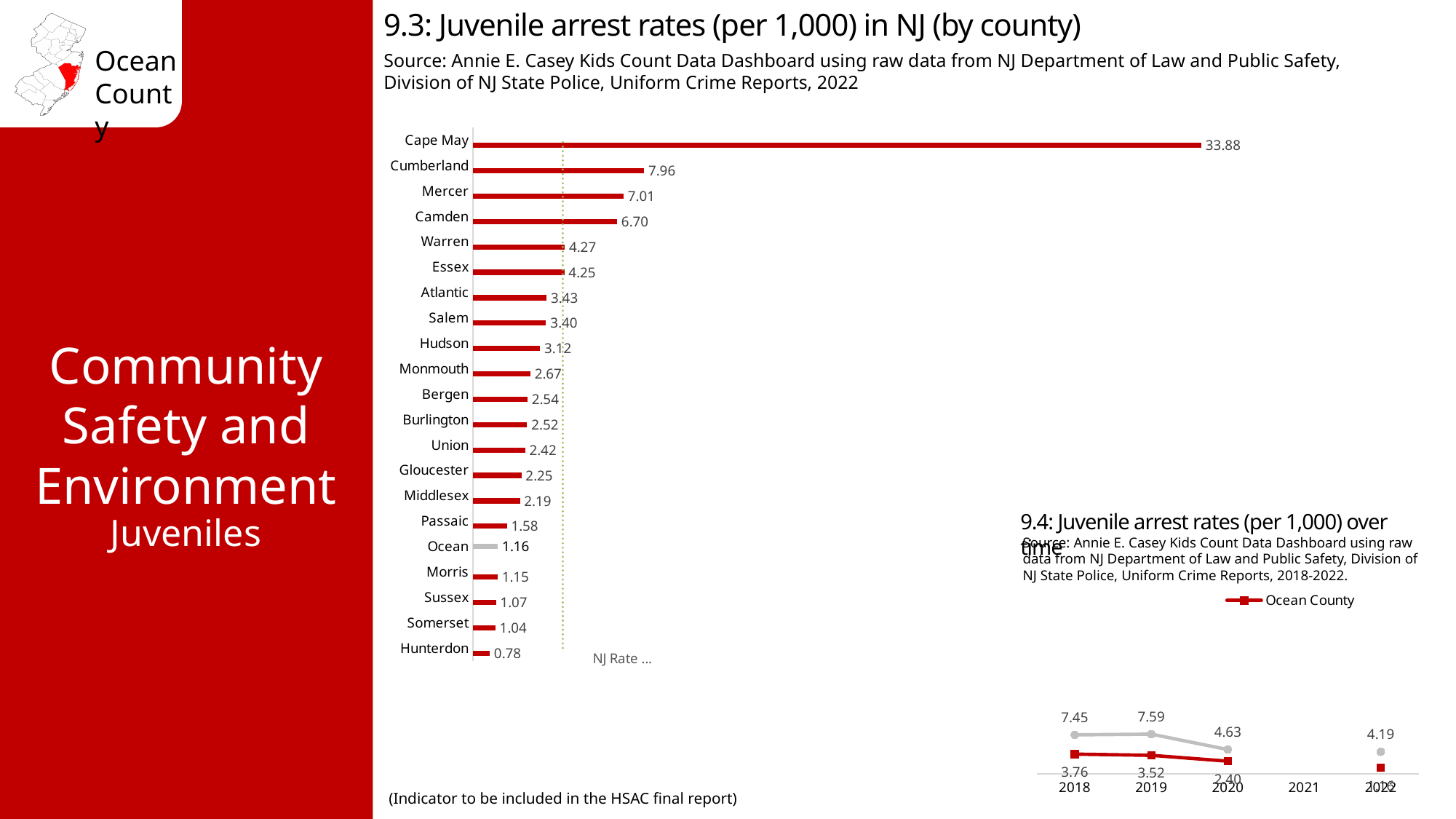
In chart 9.3, which county has the lowest juvenile arrest rate? Hunterdon In chart 9.3, how many counties are shown? 21 In chart 9.4 (Juvenile arrest rates over time), what is the Ocean County value for 2018? 3.76 In chart 9.3, which county has the highest juvenile arrest rate? Cape May In chart 9.3, what is the juvenile arrest rate for Ocean? 1.16 In chart 9.4, does the Ocean County rate rise or fall from 2018 to 2020? Fall In chart 9.3, what is the difference between the rates for Cape May and Cumberland? 25.92 In chart 9.4, what series name is listed in the legend? Ocean County In chart 9.3 (Juvenile arrest rates by county), what kind of chart is used? Bar chart In chart 9.3, what is the juvenile arrest rate for Cumberland? 7.96 In chart 9.4, what is the Ocean County value for 2020? 2.40 In chart 9.3, which has the higher juvenile arrest rate, Mercer or Camden? Mercer